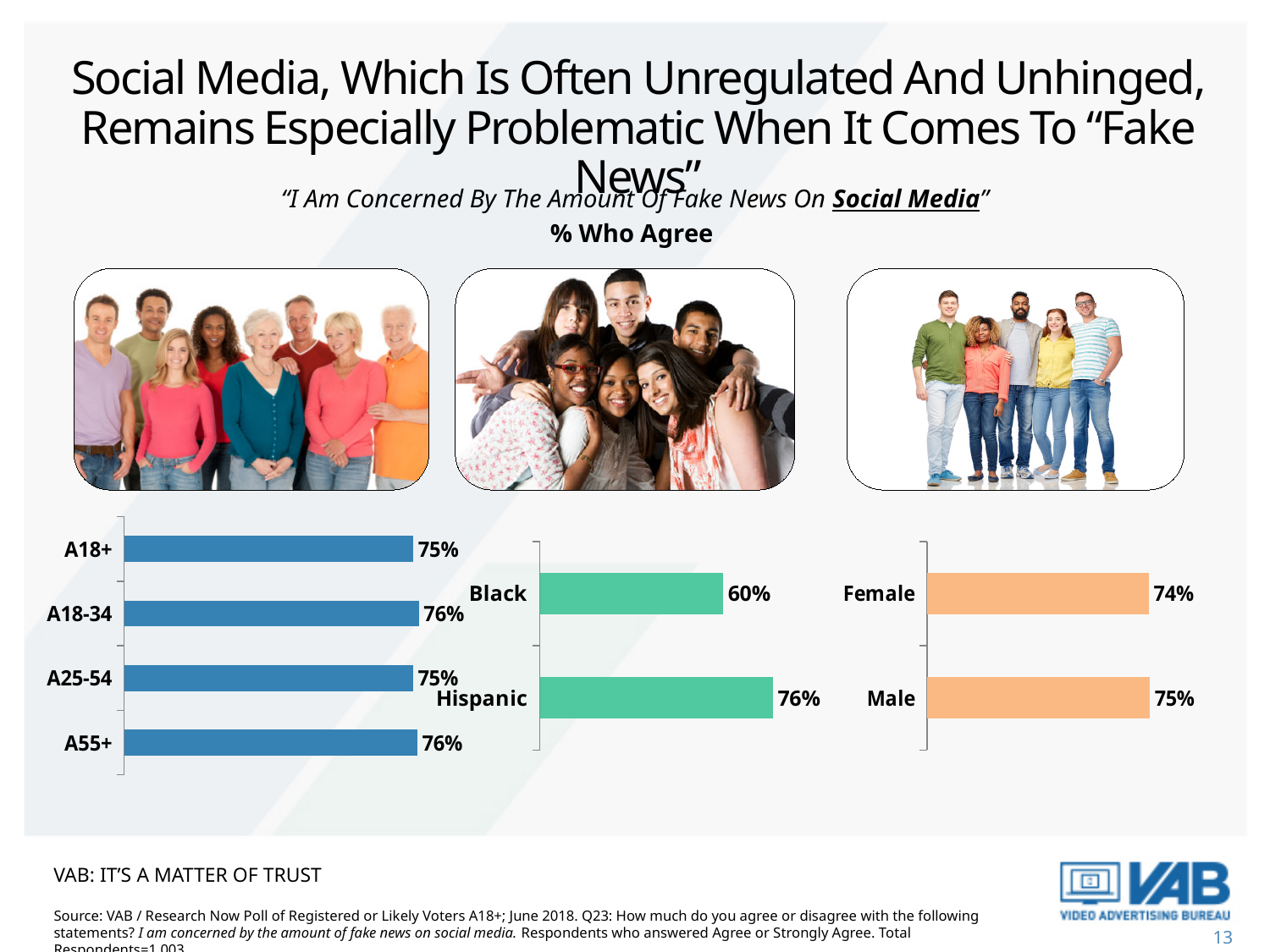
In the middle chart, what is the value for Hispanic? 76% In the middle chart, what percentage of Black respondents agree? 60% In the left chart, what is the value for A55+? 76% In the left chart, what is the value for A25-54? 75% In the middle chart, which category has the higher value, Black or Hispanic? Hispanic In the middle chart, what is the difference between the Hispanic and Black values? 16% In the left chart, what percentage of A18+ agree? 75% In the right chart, what percentage of Female respondents agree? 74% How many categories are shown in the left chart? 4 In the right chart, what is the value for Male? 75% What type of chart is the left chart? Bar chart How many categories are shown in the right chart? 2